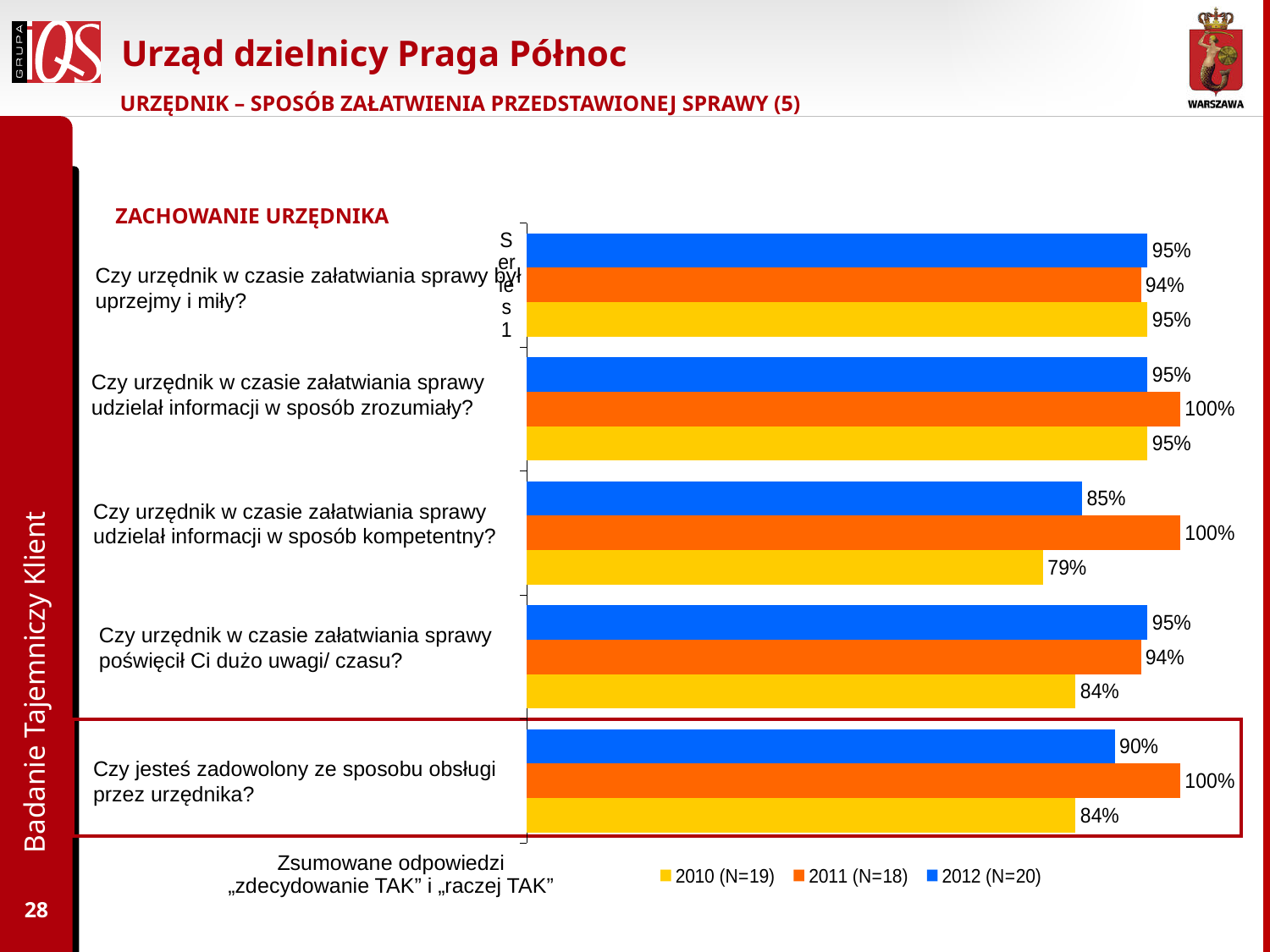
Which colour represents the 2011 (N=18) series in the chart? orange What is the 2011 (N=18) value for "Czy urzędnik w czasie załatwiania sprawy poświęcił Ci dużo uwagi/ czasu?"? 94% What is the difference between the 2012 (N=20) and 2010 (N=19) values for "Czy urzędnik w czasie załatwiania sprawy poświęcił Ci dużo uwagi/ czasu?"? 11 percentage points What type of chart is shown on the slide? bar chart How many series does the legend list? 3 For "Czy jesteś zadowolony ze sposobu obsługi przez urzędnika?", is the 2012 (N=20) value larger or smaller than the 2010 (N=19) value? larger Which year has the highest value for "Czy jesteś zadowolony ze sposobu obsługi przez urzędnika?"? 2011 (N=18) Which year has the lowest value for "Czy urzędnik w czasie załatwiania sprawy udzielał informacji w sposób kompetentny?"? 2010 (N=19) How many questions (categories) are plotted in the chart? 5 What is the 2012 (N=20) value for "Czy jesteś zadowolony ze sposobu obsługi przez urzędnika?"? 90% What is the 2010 (N=19) value for "Czy urzędnik w czasie załatwiania sprawy udzielał informacji w sposób kompetentny?"? 79% What is the difference between the 2011 (N=18) and 2010 (N=19) values for "Czy urzędnik w czasie załatwiania sprawy udzielał informacji w sposób kompetentny?"? 21 percentage points